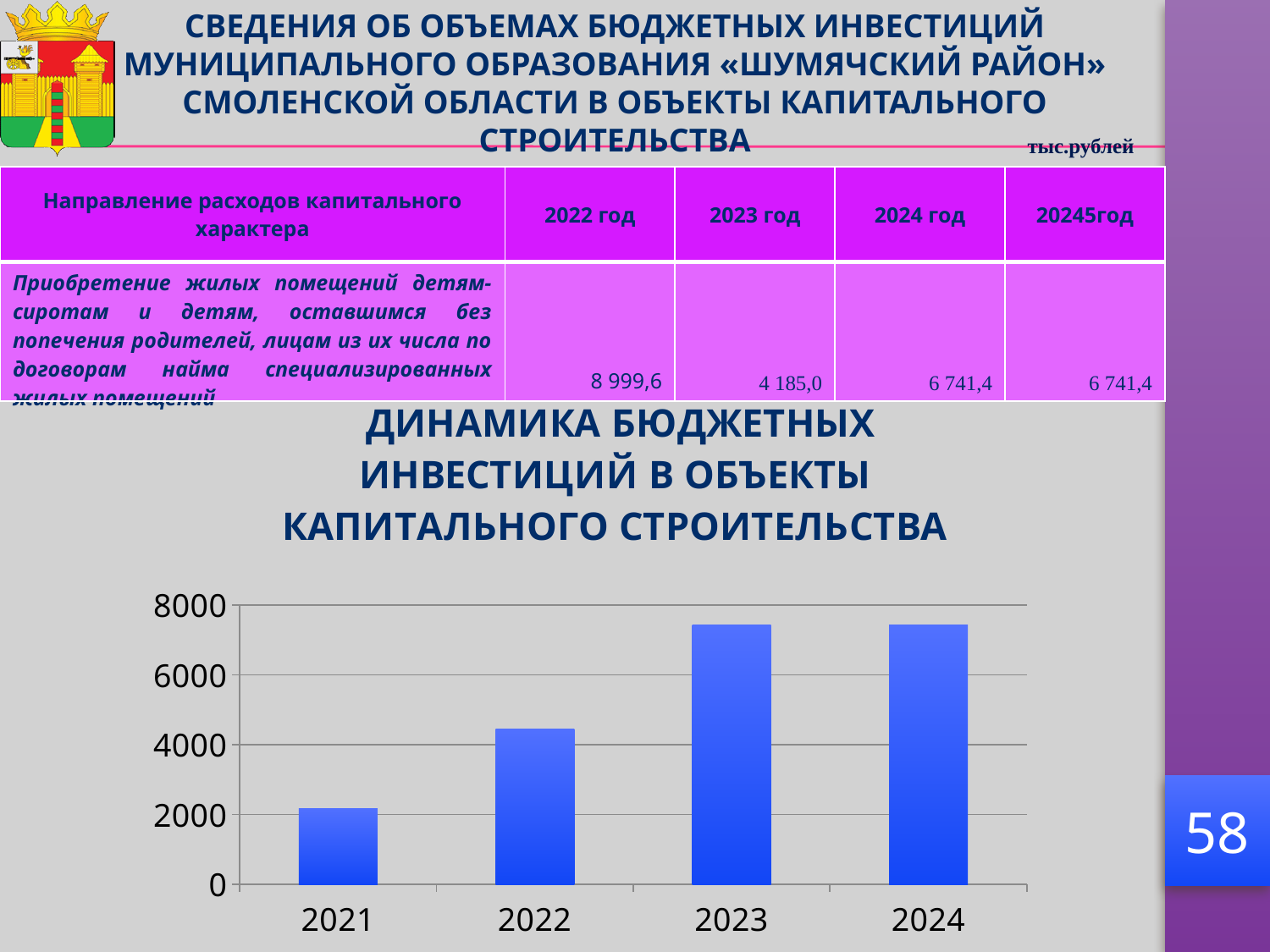
What is the highest value labelled on the vertical axis of the chart? 8000 Which bar is taller in the chart, 2021 or 2022? 2022 Is the value for 2023 in the chart greater or less than 6000? greater Is the value for 2021 in the chart greater or less than 4000? less How many years are shown on the x axis of the bar chart? 4 Is the value for 2024 in the chart greater or less than 6000? greater Which year has the lowest bar in the chart? 2021 What kind of chart is shown under the heading "ДИНАМИКА БЮДЖЕТНЫХ ИНВЕСТИЦИЙ В ОБЪЕКТЫ КАПИТАЛЬНОГО СТРОИТЕЛЬСТВА"? bar chart Which bar is taller in the chart, 2022 or 2023? 2023 Do the values in the chart rise or fall from 2021 to 2023? rise